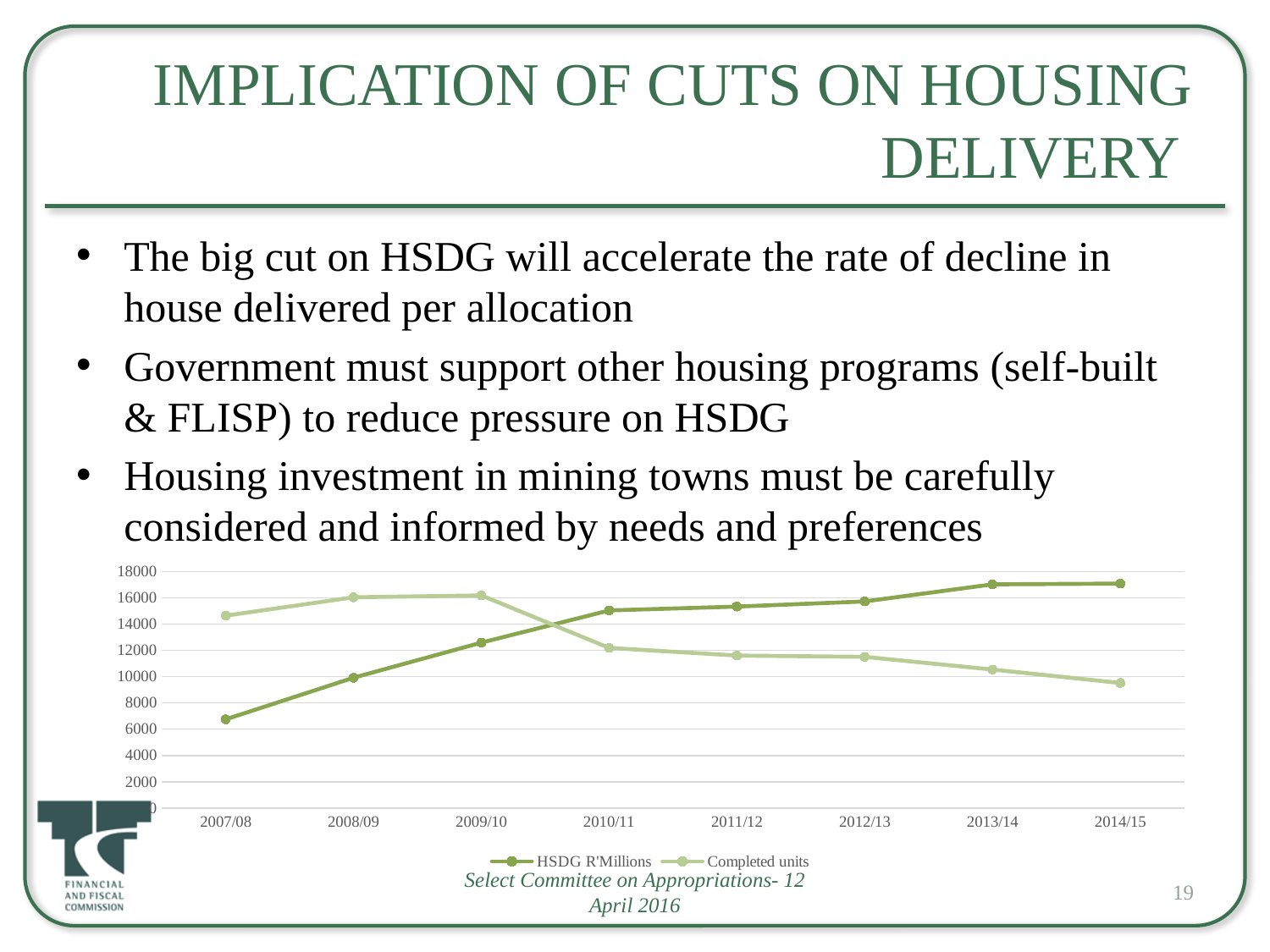
Which two series are shown in the legend? HSDG R'Millions and Completed units In which year is the Completed units value lowest? 2014/15 How many series does the legend list? 2 Does the HSDG R'Millions series rise or fall from 2007/08 to 2014/15? Rise In which year is the HSDG R'Millions value lowest? 2007/08 In 2014/15, which series has the higher value, HSDG R'Millions or Completed units? HSDG R'Millions Is the HSDG R'Millions value for 2007/08 greater or less than 8000? less What kind of chart is shown on the slide? Line chart How many years are plotted along the x axis? 8 Is the Completed units value for 2008/09 greater or less than 14000? greater Does the Completed units series rise or fall from 2009/10 to 2014/15? Fall In 2008/09, which series has the higher value, HSDG R'Millions or Completed units? Completed units